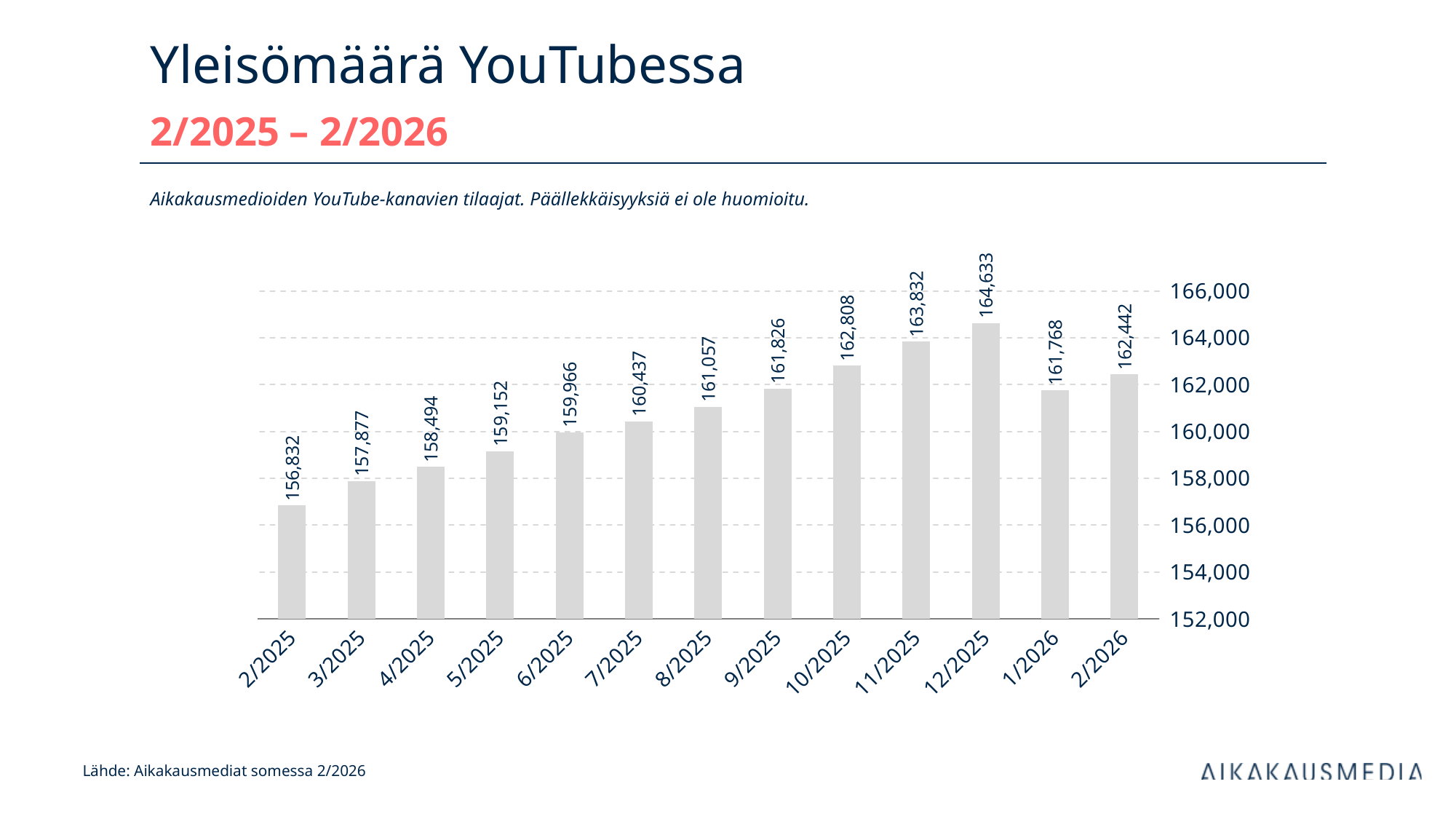
What is the value for 12/2025? 164,633 What is the value for 2/2025? 156,832 Which is larger, the value for 11/2025 or the value for 2/2026? 11/2025 What is the difference between the values for 12/2025 and 2/2025? 7,801 What is the value for 1/2026? 161,768 What is the title of the chart on the slide? Yleisömäärä YouTubessa Is the value for 6/2025 greater or less than 158,000? greater What kind of chart is shown on the slide? Bar chart Which month has the lowest value? 2/2025 What is the difference between the values for 2/2026 and 1/2026? 674 How many months are shown on the x axis? 13 Which month has the highest value? 12/2025